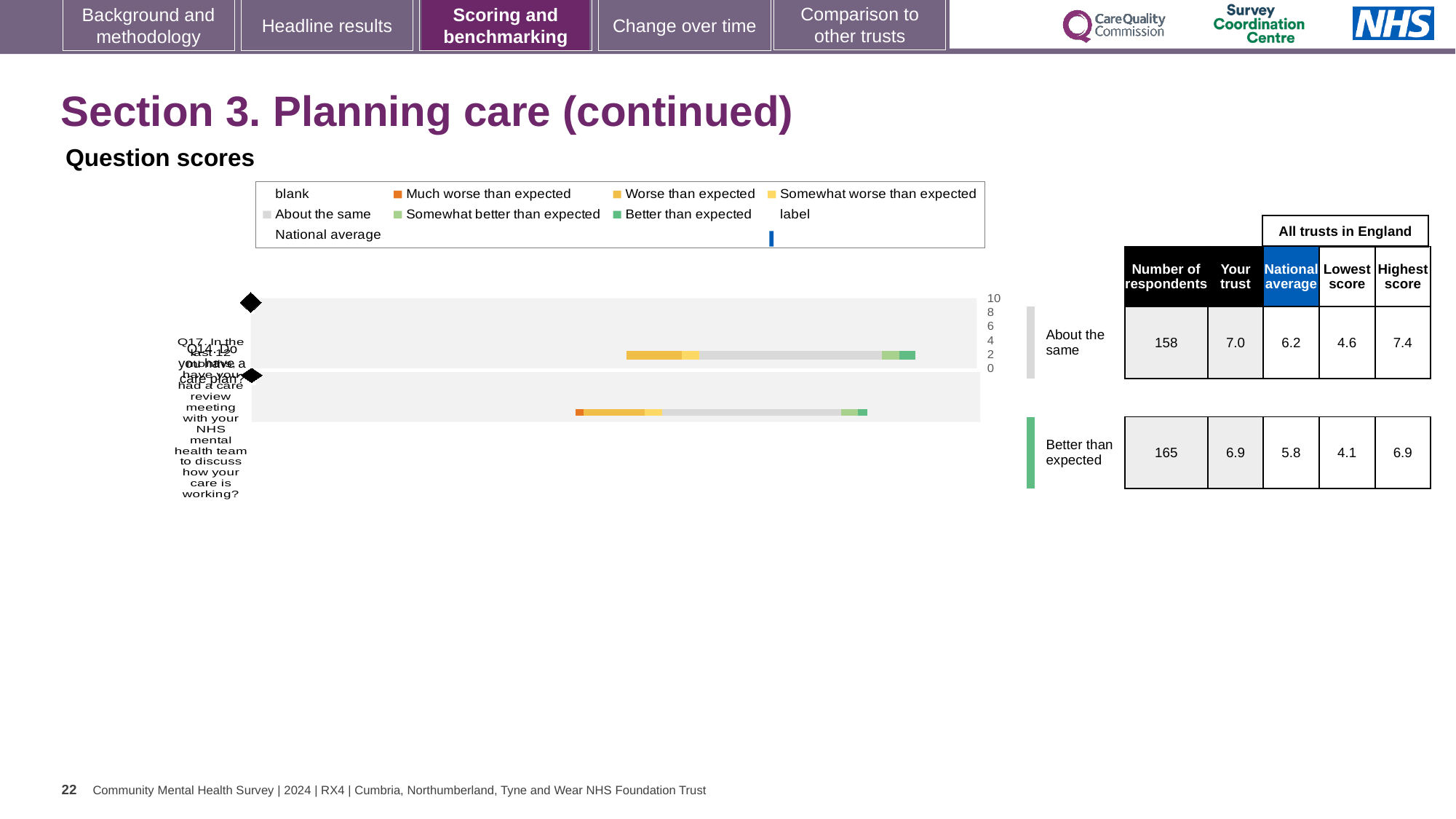
In the table, what is the national average for the row labelled 'About the same'? 6.2 In the table, what is the highest score for the row labelled 'About the same'? 7.4 For the row labelled 'Better than expected', which is larger: the 'Your trust' score or the national average? Your trust In the table, what is the 'Your trust' score for the row labelled 'Better than expected'? 6.9 For the row labelled 'About the same', what is the difference between the 'Your trust' score and the national average? 0.8 For the row labelled 'Better than expected', what is the difference between the highest score and the lowest score? 2.8 In the table, what is the number of respondents for the row labelled 'About the same'? 158 How many question bars are plotted in the chart? 2 What heading appears above the 'Lowest score' and 'Highest score' columns in the table? All trusts in England What kind of chart is shown under 'Question scores'? bar chart In the table, what is the lowest score for the row labelled 'Better than expected'? 4.1 Which row has the larger number of respondents, 'About the same' or 'Better than expected'? Better than expected